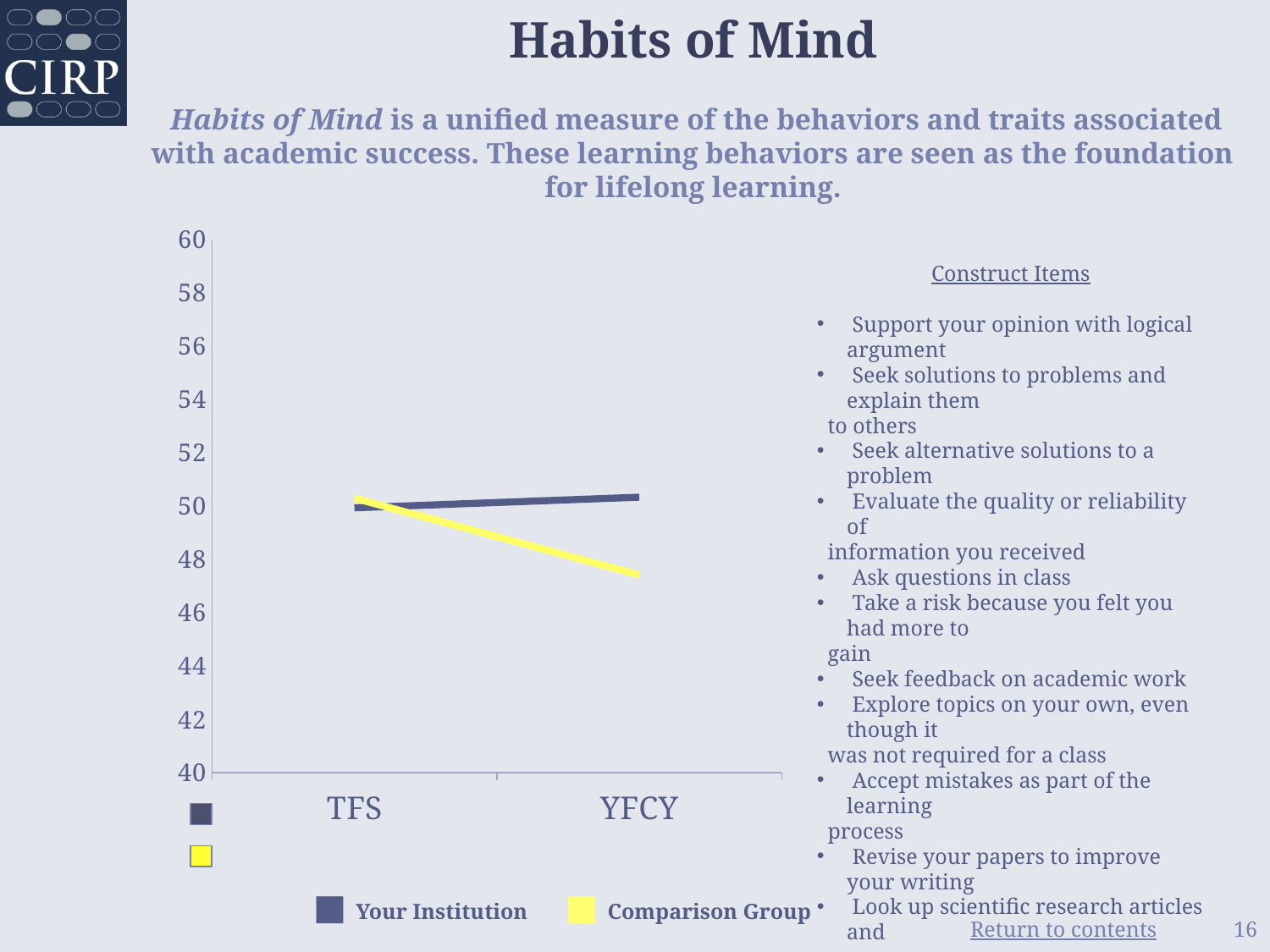
Is the value for Your Institution at YFCY greater or less than 48? greater Does the Your Institution line rise or fall from TFS to YFCY? rise Is the value for Comparison Group at YFCY greater or less than 50? less Which series is shown in yellow in the chart? Comparison Group What kind of chart is shown on the slide? line chart How many categories are shown on the x axis of the chart? 2 Which series has the lowest value at YFCY? Comparison Group Is the value for Comparison Group at TFS greater or less than 46? greater What are the two categories on the x axis of the chart? TFS and YFCY Does the Comparison Group line rise or fall from TFS to YFCY? fall At YFCY, which series has the higher value, Your Institution or Comparison Group? Your Institution How many series does the chart legend list? 2